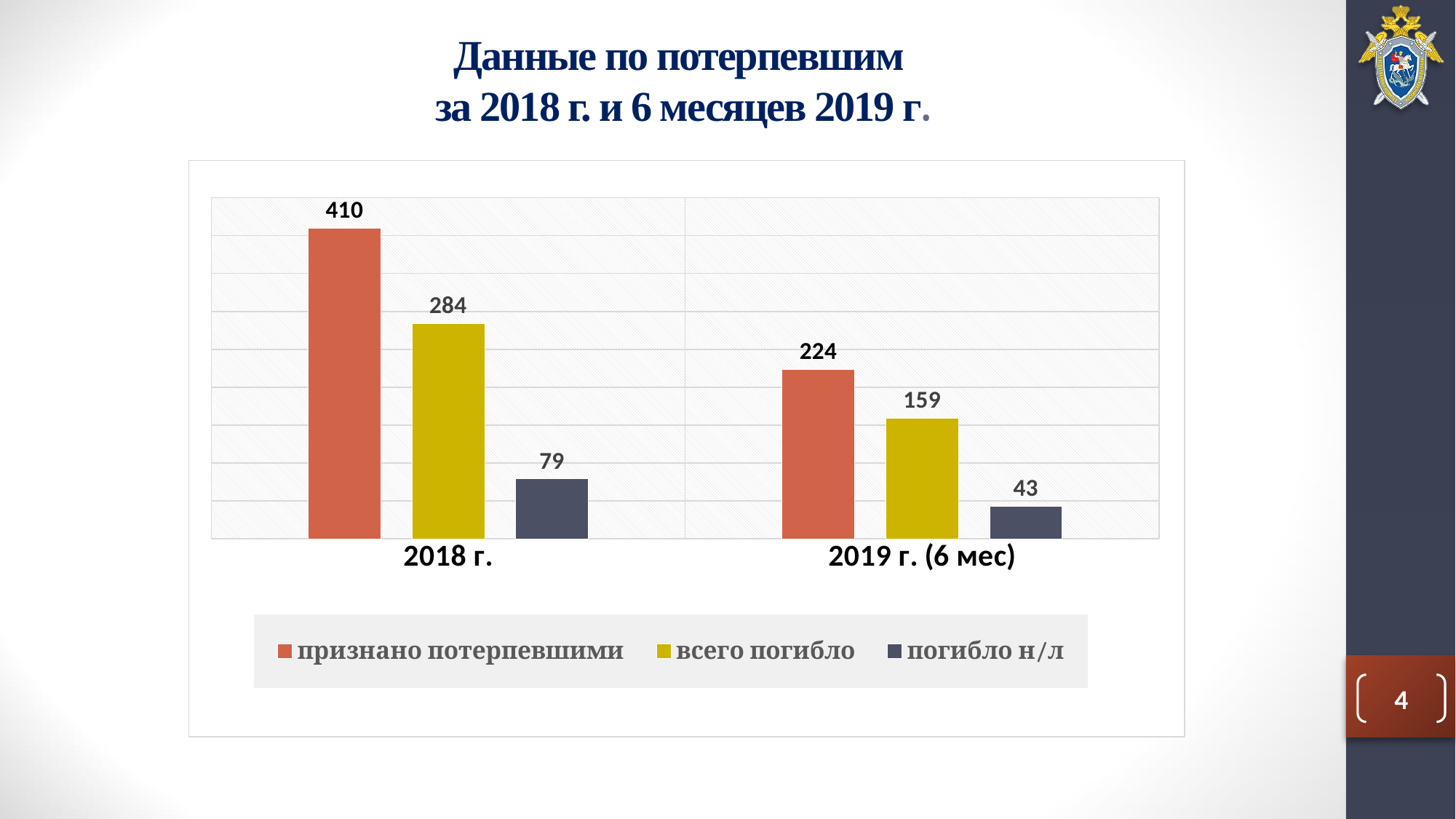
What is the value for "признано потерпевшими" in 2018 г.? 410 Which is larger: "погибло н/л" in 2018 г. or "погибло н/л" in 2019 г. (6 мес)? 2018 г. Which category has the highest value for "признано потерпевшими"? 2018 г. What kind of chart is shown on the slide? bar chart What is the value for "погибло н/л" in 2018 г.? 79 What is the difference between "признано потерпевшими" and "всего погибло" in 2018 г.? 126 Which series has the lowest value in 2019 г. (6 мес)? погибло н/л How many series does the legend list? 3 What colour represents the series "всего погибло"? yellow What is the difference between "всего погибло" in 2018 г. and in 2019 г. (6 мес)? 125 What is the value for "всего погибло" in 2019 г. (6 мес)? 159 How many categories are shown on the x axis? 2